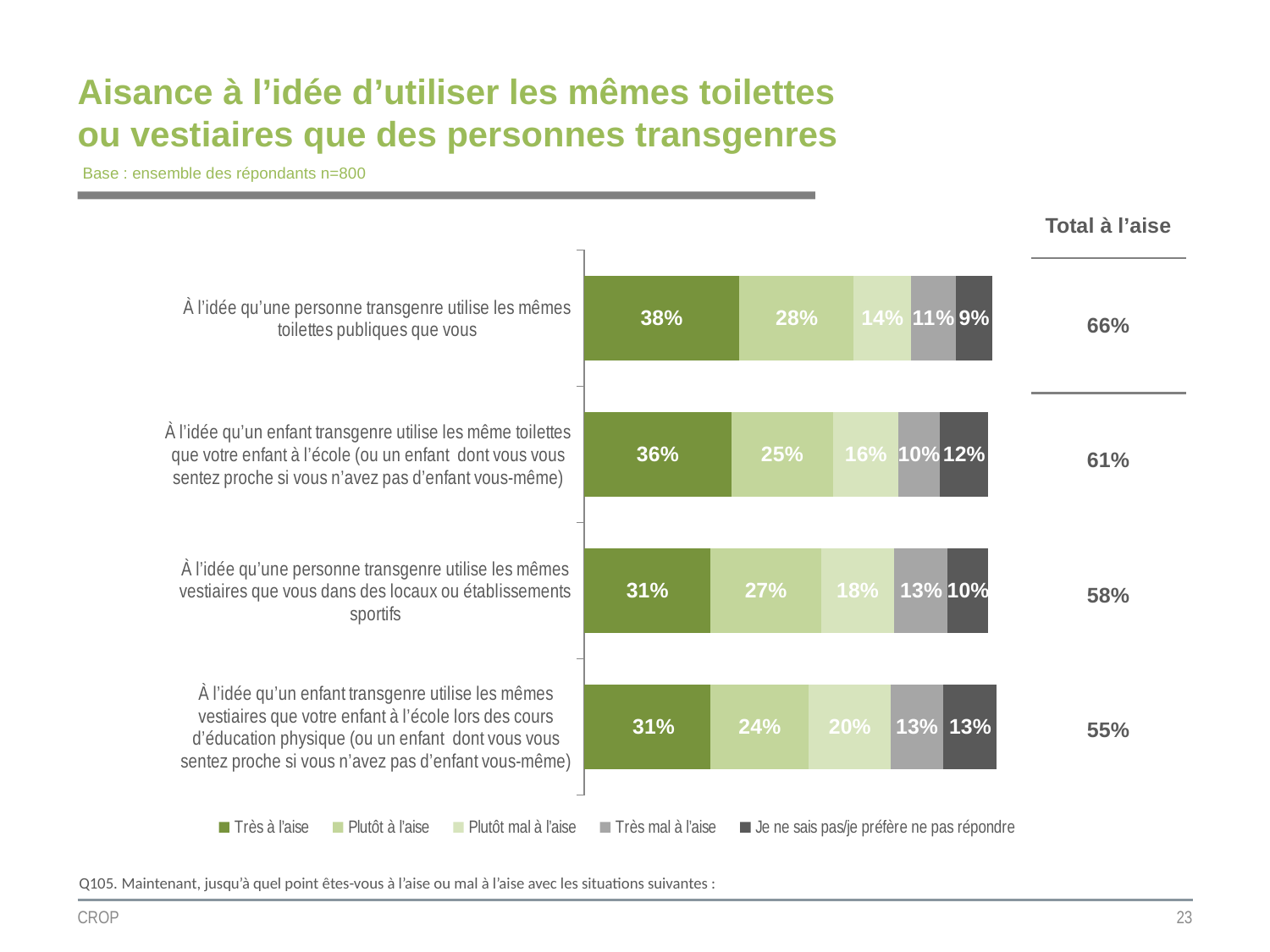
What is the "Je ne sais pas/je préfère ne pas répondre" value for the item about a transgender child using the same toilets as your child at school? 12% What percentage of respondents answered "Très à l'aise" for the item "À l'idée qu'une personne transgenre utilise les mêmes toilettes publiques que vous"? 38% What is the base (sample size) stated under the chart title? n=800 Which item has the lowest "Total à l'aise" value? À l'idée qu'un enfant transgenre utilise les mêmes vestiaires que votre enfant à l'école lors des cours d'éducation physique What is the "Plutôt mal à l'aise" value for the item about a transgender person using the same "vestiaires" in sports facilities ("locaux ou établissements sportifs")? 18% What is the difference between the highest and lowest "Total à l'aise" values? 11 percentage points How many series does the legend list? 5 Which is larger: the "Plutôt à l'aise" value for the public toilets item or for the item about a transgender child using the same vestiaires during physical education classes? The public toilets item (28% vs 24%) How many items (categories) are shown in the chart? 4 What type of chart is shown on the slide? Stacked bar chart Which item has the highest "Très à l'aise" percentage? À l'idée qu'une personne transgenre utilise les mêmes toilettes publiques que vous What is the total of the stacked bar for the item "À l'idée qu'une personne transgenre utilise les mêmes toilettes publiques que vous"? 100%